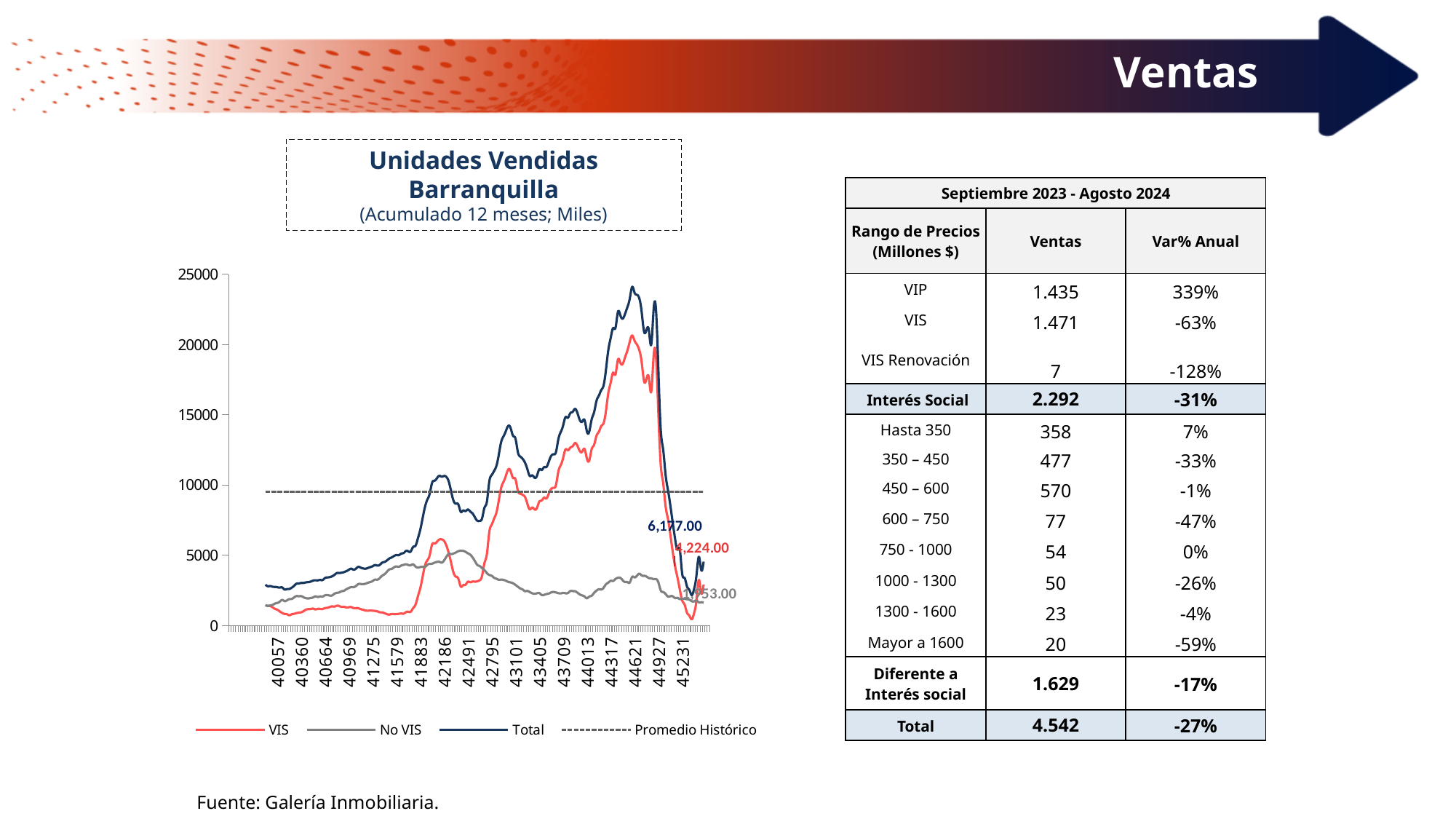
In the 'Unidades Vendidas Barranquilla' chart, does the Total line rise or fall between the x-axis labels 44621 and 45231? fall In the 'Unidades Vendidas Barranquilla' chart, is the Promedio Histórico line greater or less than 10000? less In the 'Unidades Vendidas Barranquilla' chart, which series reaches the highest value? Total In the 'Unidades Vendidas Barranquilla' chart, what is the difference between the final labelled Total value and the final labelled VIS value? 1,953.00 What is the final labelled value of the Total series in the 'Unidades Vendidas Barranquilla' chart? 6,177.00 What is the final labelled value of the VIS series in the 'Unidades Vendidas Barranquilla' chart? 4,224.00 What kind of chart is 'Unidades Vendidas Barranquilla'? line chart What subtitle appears under the title 'Unidades Vendidas Barranquilla'? (Acumulado 12 meses; Miles) In the 'Unidades Vendidas Barranquilla' chart, is the peak of the Total line greater or less than 20000? greater What colour is the VIS line in the 'Unidades Vendidas Barranquilla' chart? red How many series does the legend of the 'Unidades Vendidas Barranquilla' chart list? 4 In the 'Unidades Vendidas Barranquilla' chart, which series has the higher peak, VIS or No VIS? VIS